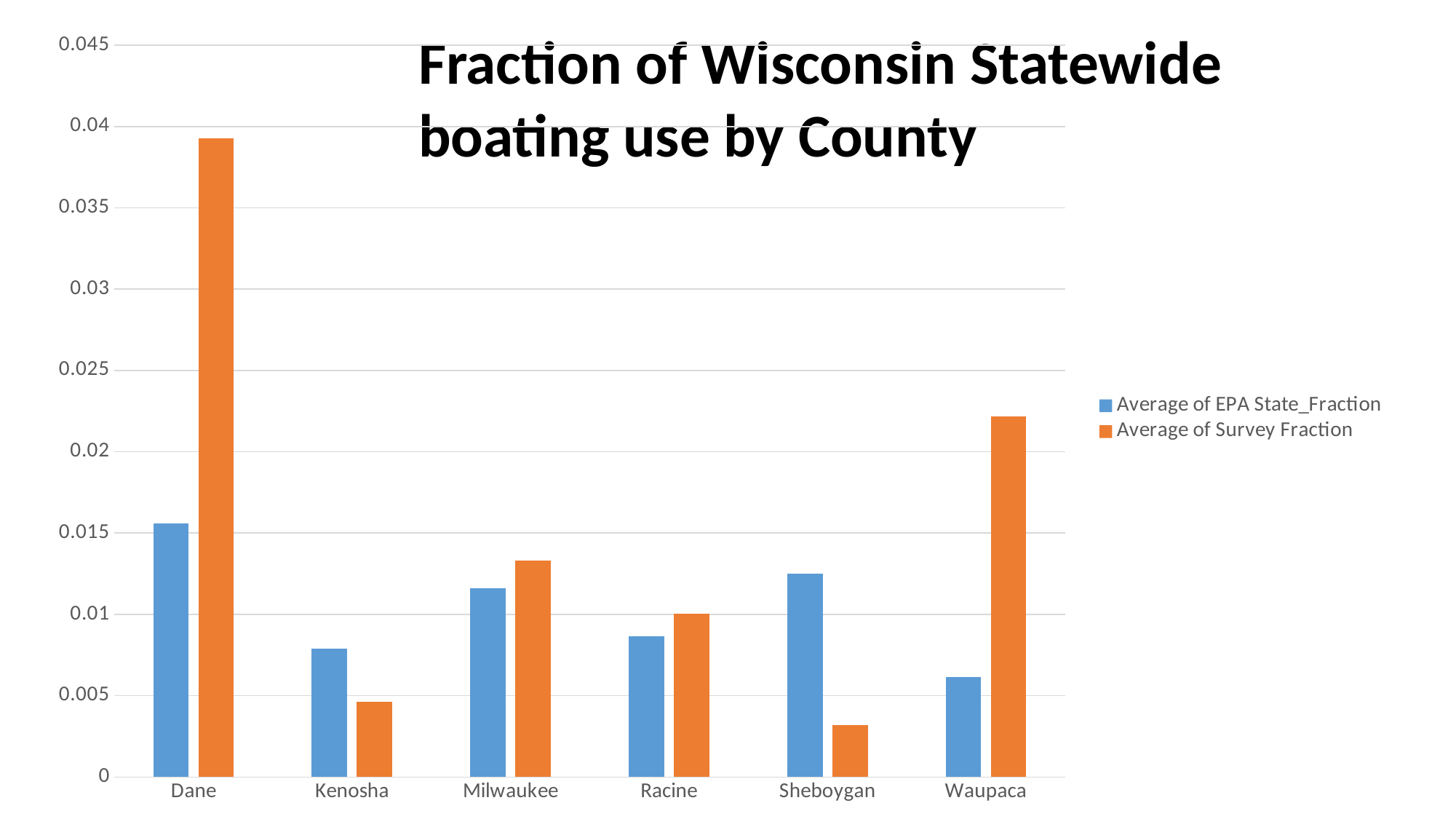
Which county has the lowest Average of Survey Fraction? Sheboygan What is the title of the chart? Fraction of Wisconsin Statewide boating use by County How many counties are shown on the x axis? 6 For Waupaca, which is larger: Average of EPA State_Fraction or Average of Survey Fraction? Average of Survey Fraction Is the Average of Survey Fraction for Sheboygan greater or less than 0.005? less Which county has the highest Average of EPA State_Fraction? Dane Is the Average of Survey Fraction for Dane greater or less than 0.035? greater Which county has the lowest Average of EPA State_Fraction? Waupaca What type of chart is shown on the slide? Bar chart For Sheboygan, which is larger: Average of EPA State_Fraction or Average of Survey Fraction? Average of EPA State_Fraction Which county has the highest Average of Survey Fraction? Dane How many series does the legend list? 2